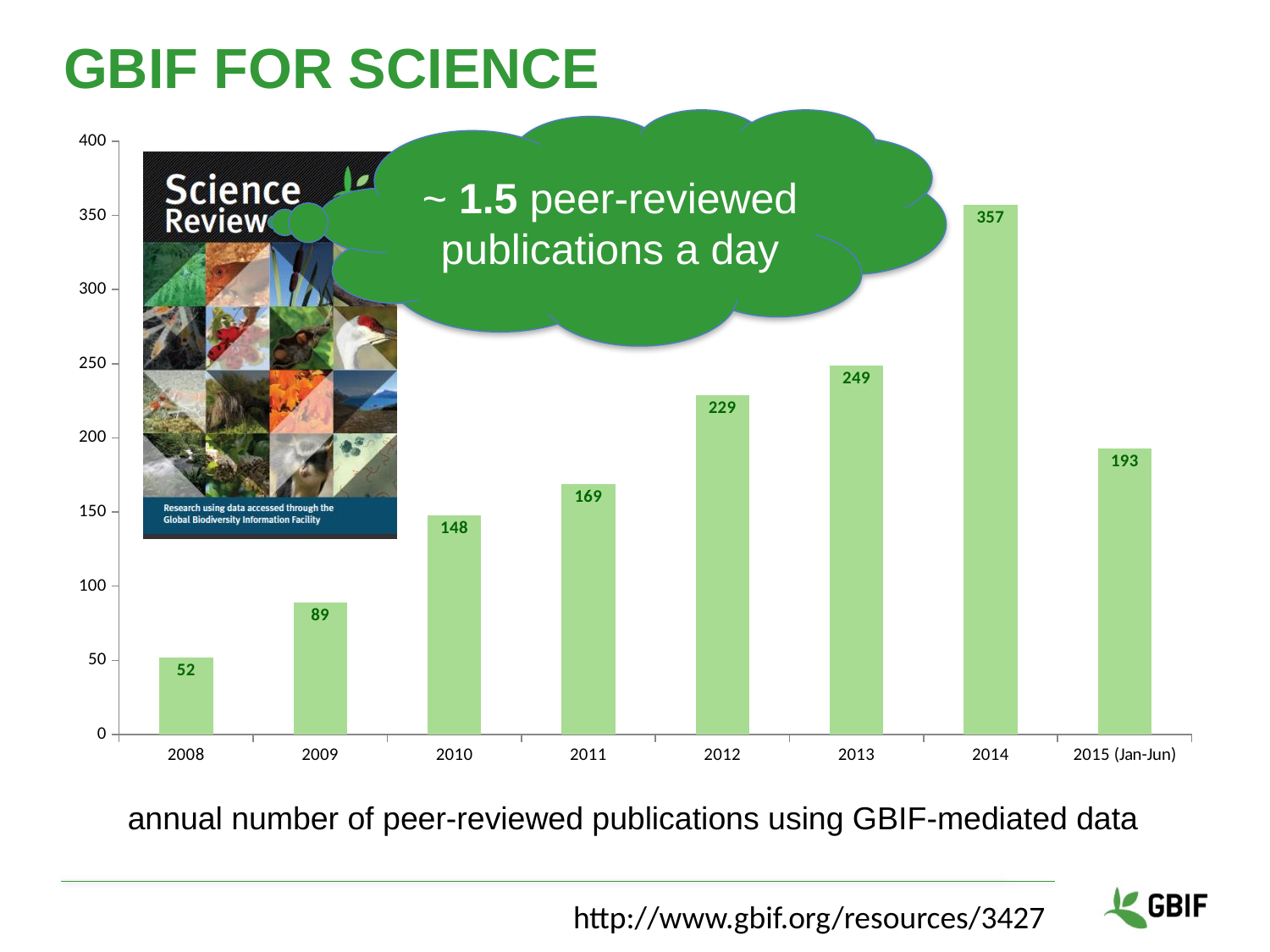
Which year has the lowest number of publications? 2008 What is the value shown for 2008? 52 Is the value for 2011 greater or less than 150? greater What is the number of peer-reviewed publications for 2014? 357 What is the value shown for 2015 (Jan-Jun)? 193 Do the values rise or fall from 2008 to 2014? rise How many bars are shown in the chart? 8 What is the difference between the values for 2014 and 2013? 108 What is the difference between the values for 2010 and 2009? 59 Which year has the highest number of publications? 2014 Which is larger, the value for 2012 or the value for 2015 (Jan-Jun)? 2012 What kind of chart is shown on the slide? bar chart